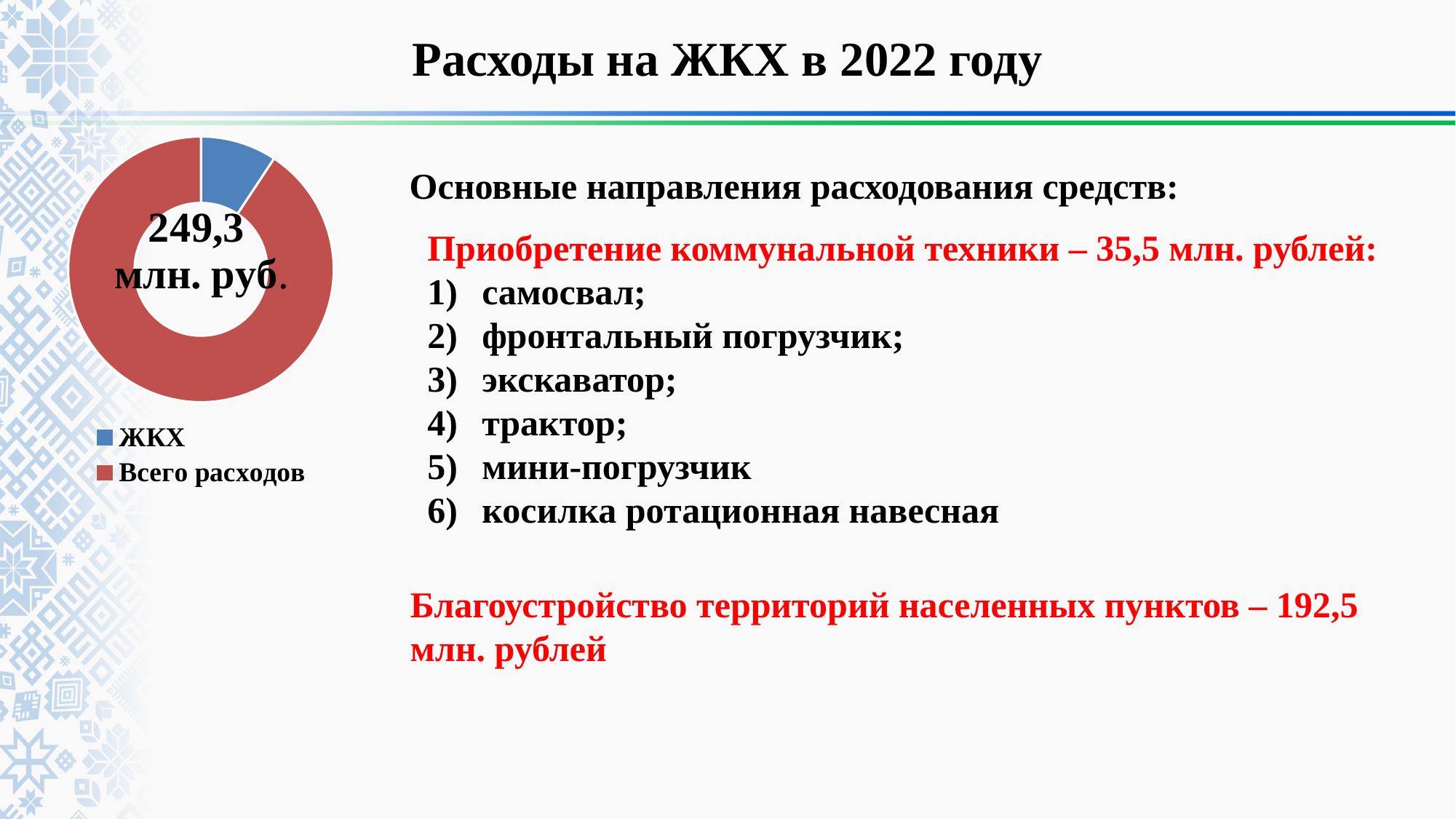
How many categories does the doughnut chart show? 2 What value is printed in the centre of the doughnut chart? 249,3 млн. руб. Which category takes the largest share of the doughnut chart? Всего расходов What kind of chart is shown on the slide? Doughnut (pie) chart Which category takes the smallest share of the doughnut chart? ЖКХ Which is larger in the doughnut chart, ЖКХ or Всего расходов? Всего расходов What colour represents ЖКХ in the doughnut chart? Blue How many entries does the chart legend list? 2